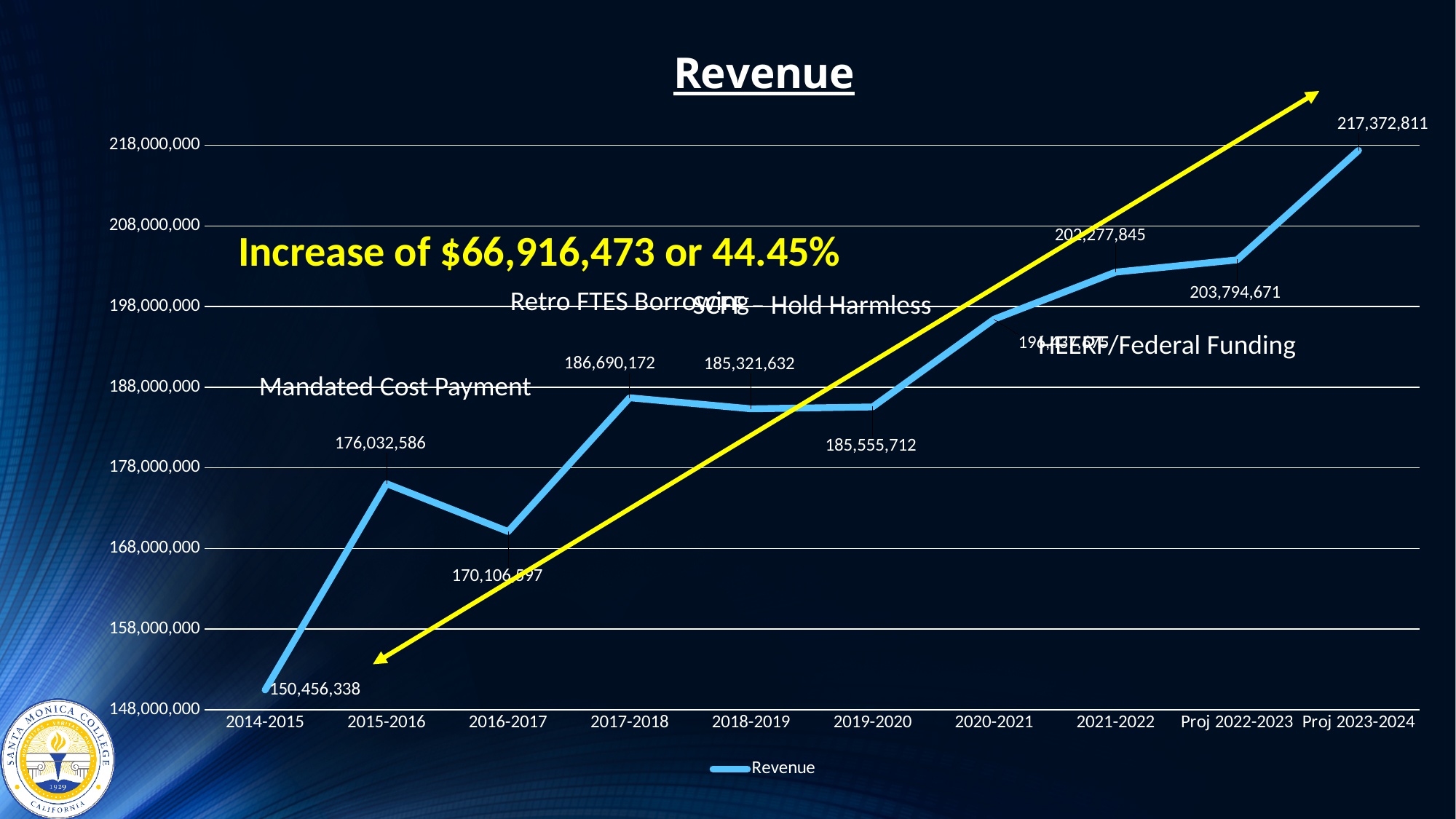
What is the revenue value for 2014-2015? 150,456,338 Is the revenue for 2020-2021 greater or less than 188,000,000? greater What is the revenue value for Proj 2023-2024? 217,372,811 Which year has the lowest revenue? 2014-2015 How many years are plotted on the x axis? 10 What is the difference between the revenue for 2015-2016 and 2016-2017? 5,925,989 What is the difference between the revenue for Proj 2023-2024 and 2014-2015? 66,916,473 What kind of chart is shown on the slide? line chart Which year has the highest revenue? Proj 2023-2024 Does revenue generally rise or fall from 2014-2015 to Proj 2023-2024? rise How many series does the legend list? 1 What is the revenue value for 2016-2017? 170,106,597